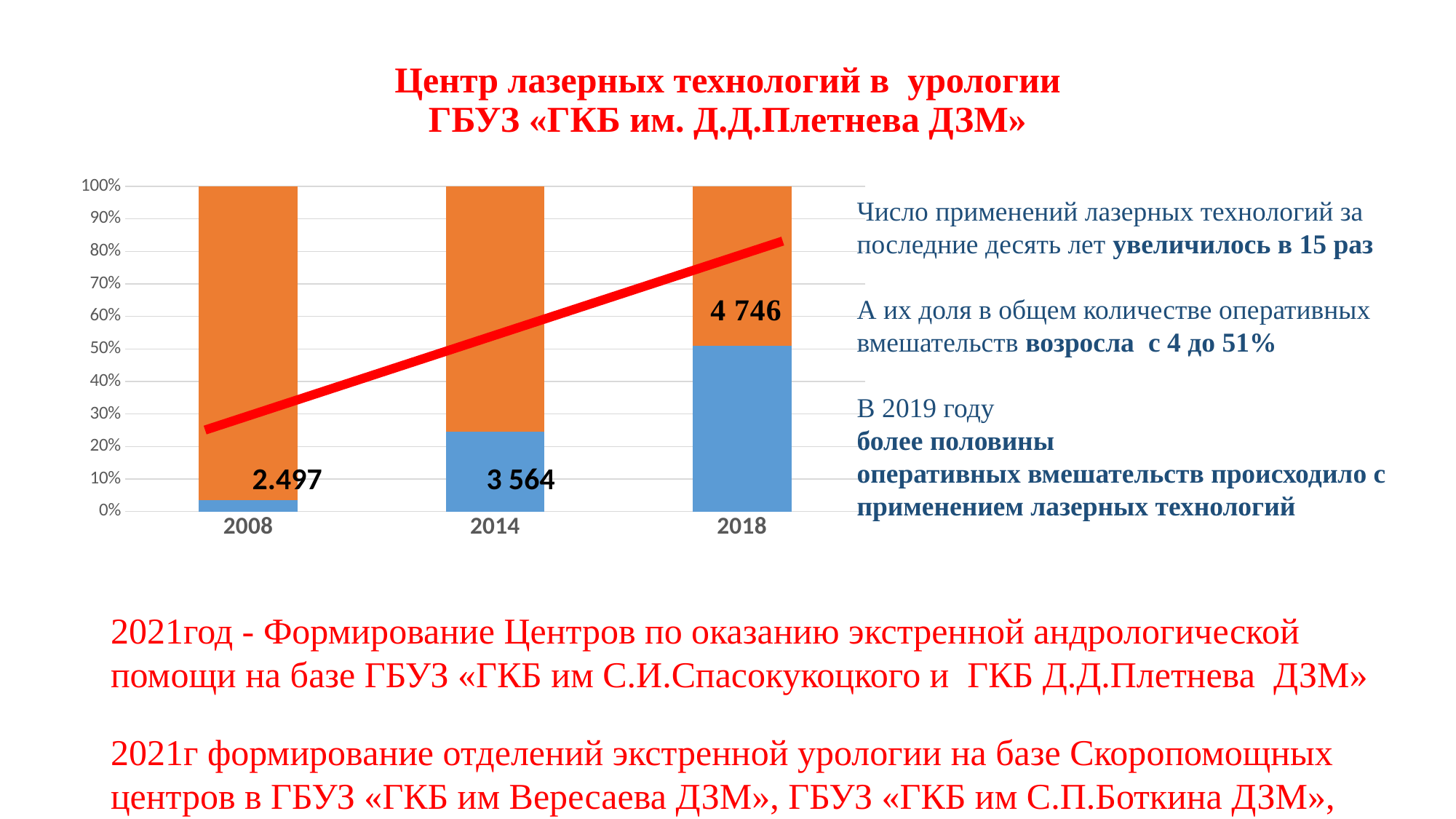
What colour is the bottom segment of each stacked bar? Blue What value is printed on the bar for 2014? 3 564 What value is printed on the bar for 2008? 2.497 Which year has the smallest printed value on its bar? 2008 How many years (categories) are shown on the x axis of the chart? 3 What kind of chart is shown on the slide? Stacked bar chart Which year has the larger blue segment, 2014 or 2018? 2018 Which year has the largest printed value on its bar? 2018 Does the blue share of the bars rise or fall from 2008 to 2018? Rises What value is printed on the bar for 2018? 4 746 Is the blue share of the bar for 2014 greater or less than 30%? less What is the difference between the printed values for 2018 and 2014? 1 182